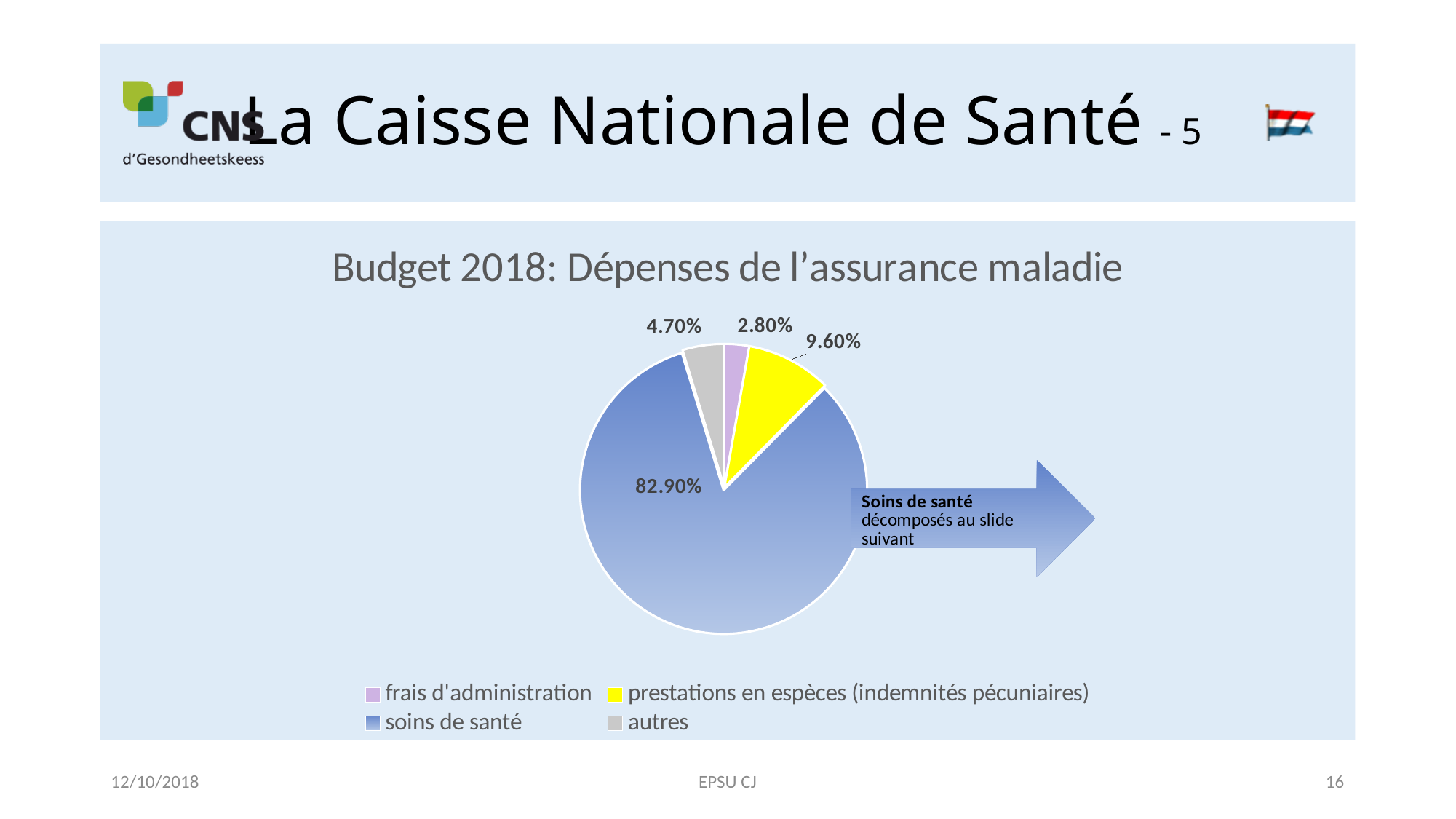
Which category has the smallest share of the pie? frais d'administration Which is larger: the share for 'autres' or the share for 'prestations en espèces (indemnités pécuniaires)'? prestations en espèces (indemnités pécuniaires) How many categories does the pie chart show? 4 What share of the pie does 'prestations en espèces (indemnités pécuniaires)' represent? 9.60% What share of the pie does 'autres' represent? 4.70% What is the title of the chart? Budget 2018: Dépenses de l'assurance maladie What share of the pie does 'soins de santé' represent? 82.90% What colour is the slice for 'prestations en espèces (indemnités pécuniaires)'? yellow What type of chart is shown on the slide? pie chart What is the difference in percentage points between 'soins de santé' and 'prestations en espèces (indemnités pécuniaires)'? 73.30% What share of the pie does 'frais d'administration' represent? 2.80% Which category has the largest share of the pie? soins de santé